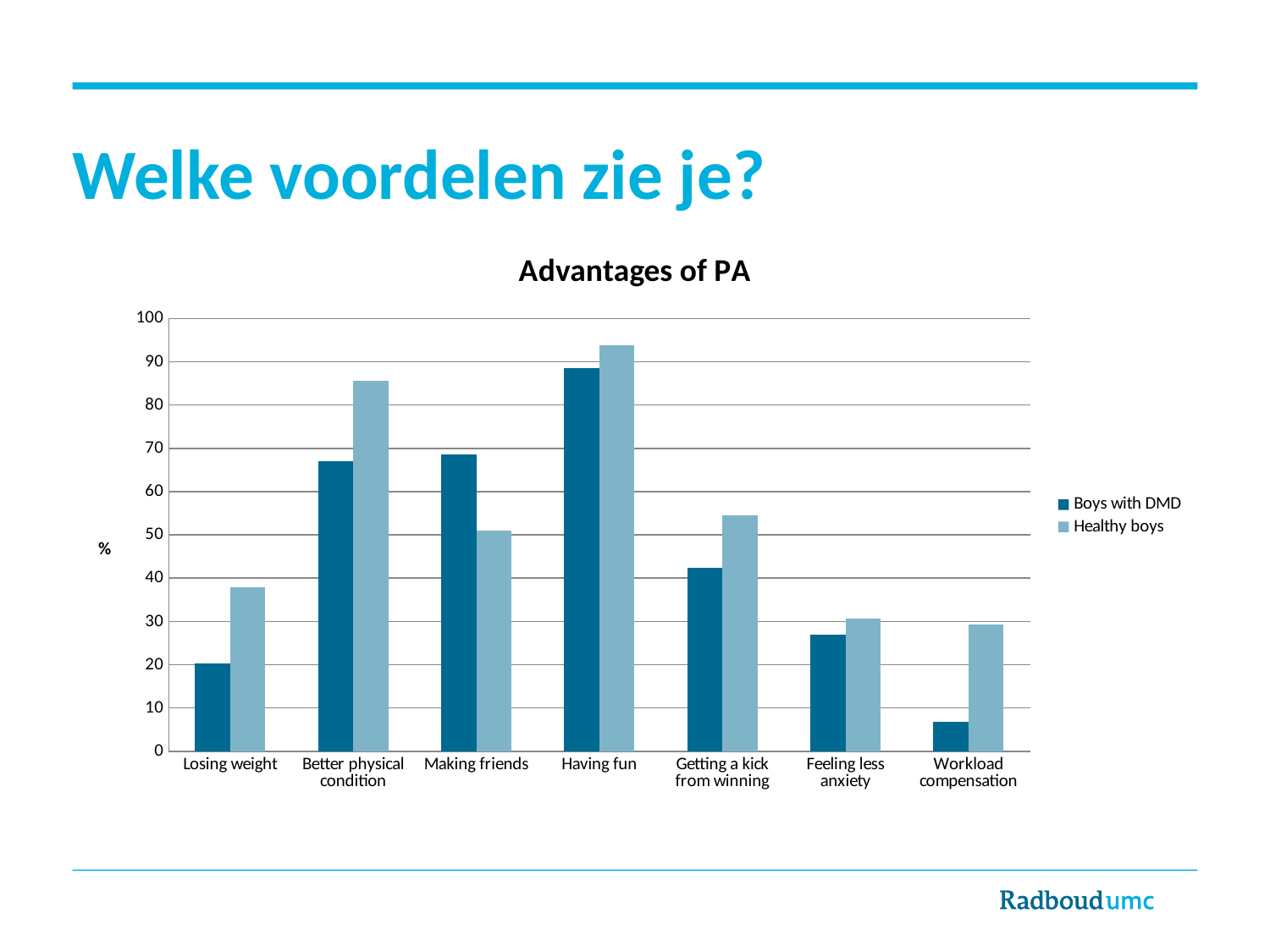
What kind of chart is shown on the slide? bar chart How many categories are shown on the x axis of the chart? 7 How many series does the legend list? 2 Is the value for Healthy boys for Better physical condition greater or less than 80? greater Is the value for Boys with DMD for Workload compensation greater or less than 10? less What is the label on the vertical axis of the chart? % For Losing weight, which series has the larger value: Boys with DMD or Healthy boys? Healthy boys For which category is the value for Boys with DMD highest? Having fun For which category is the value for Boys with DMD lowest? Workload compensation For Making friends, which series has the larger value: Boys with DMD or Healthy boys? Boys with DMD For which category is the value for Healthy boys highest? Having fun What is the title of the chart? Advantages of PA